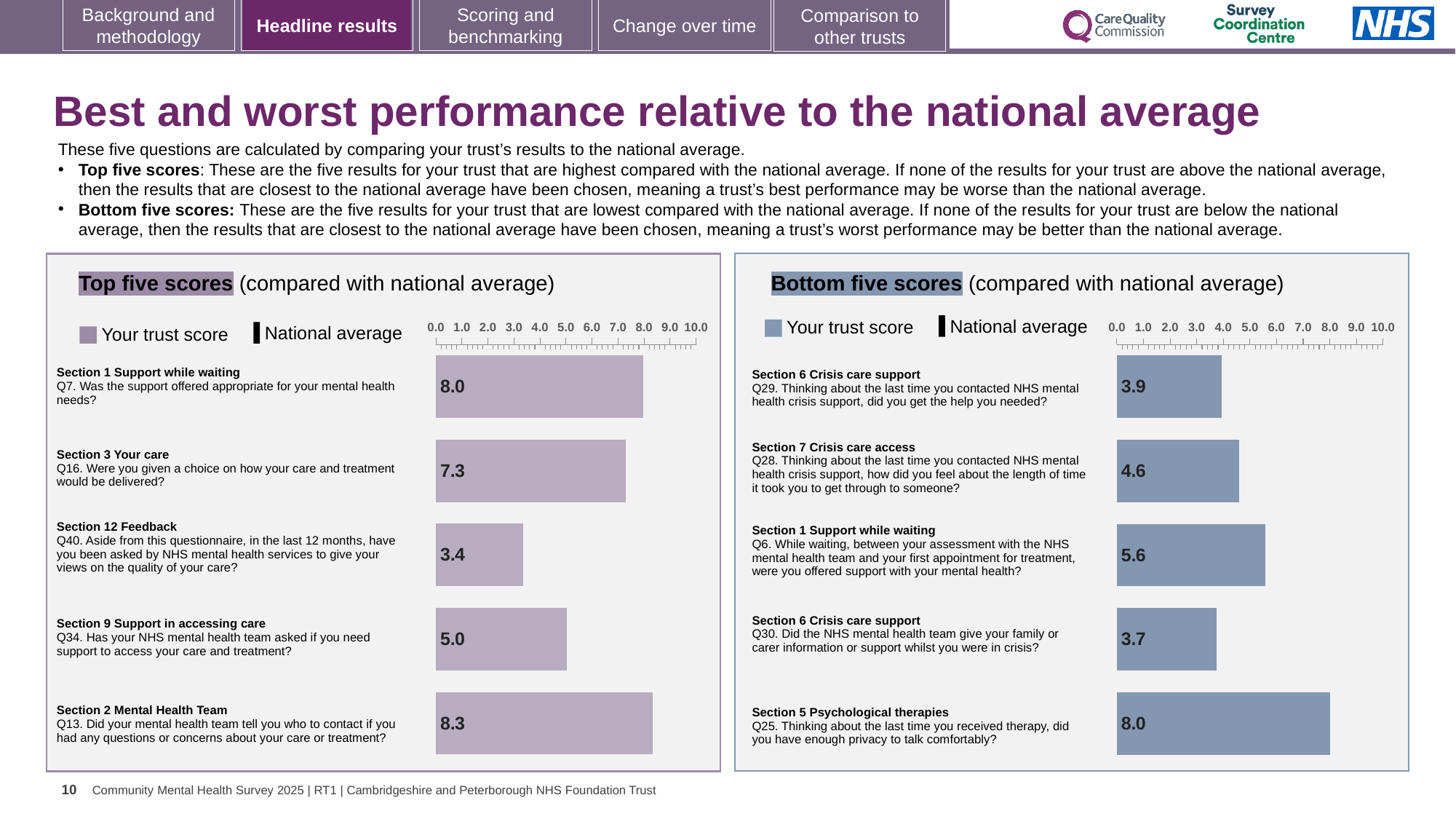
In the Bottom five scores chart, which question has the highest trust score? Q25 (8.0) In the Bottom five scores chart, what is the difference between the trust scores for Q25 and Q29? 4.1 In the Top five scores chart, which question has the highest trust score? Q13 (8.3) In the Top five scores chart, which has the higher trust score, Q16 or Q34? Q16 In the Top five scores chart, which question has the lowest trust score? Q40 (3.4) In the Bottom five scores chart, what is the trust score for Q25 (enough privacy to talk comfortably)? 8.0 How many bars are shown in the Bottom five scores chart? 5 In the Bottom five scores chart, which question has the lowest trust score? Q30 (3.7) In the Top five scores chart, what is the trust score for Q7 (Was the support offered appropriate for your mental health needs?)? 8.0 In the Top five scores chart, what is the difference between the trust scores for Q13 and Q40? 4.9 What kind of chart is the Top five scores chart? Bar chart How many entries does the legend of the Top five scores chart list? 2